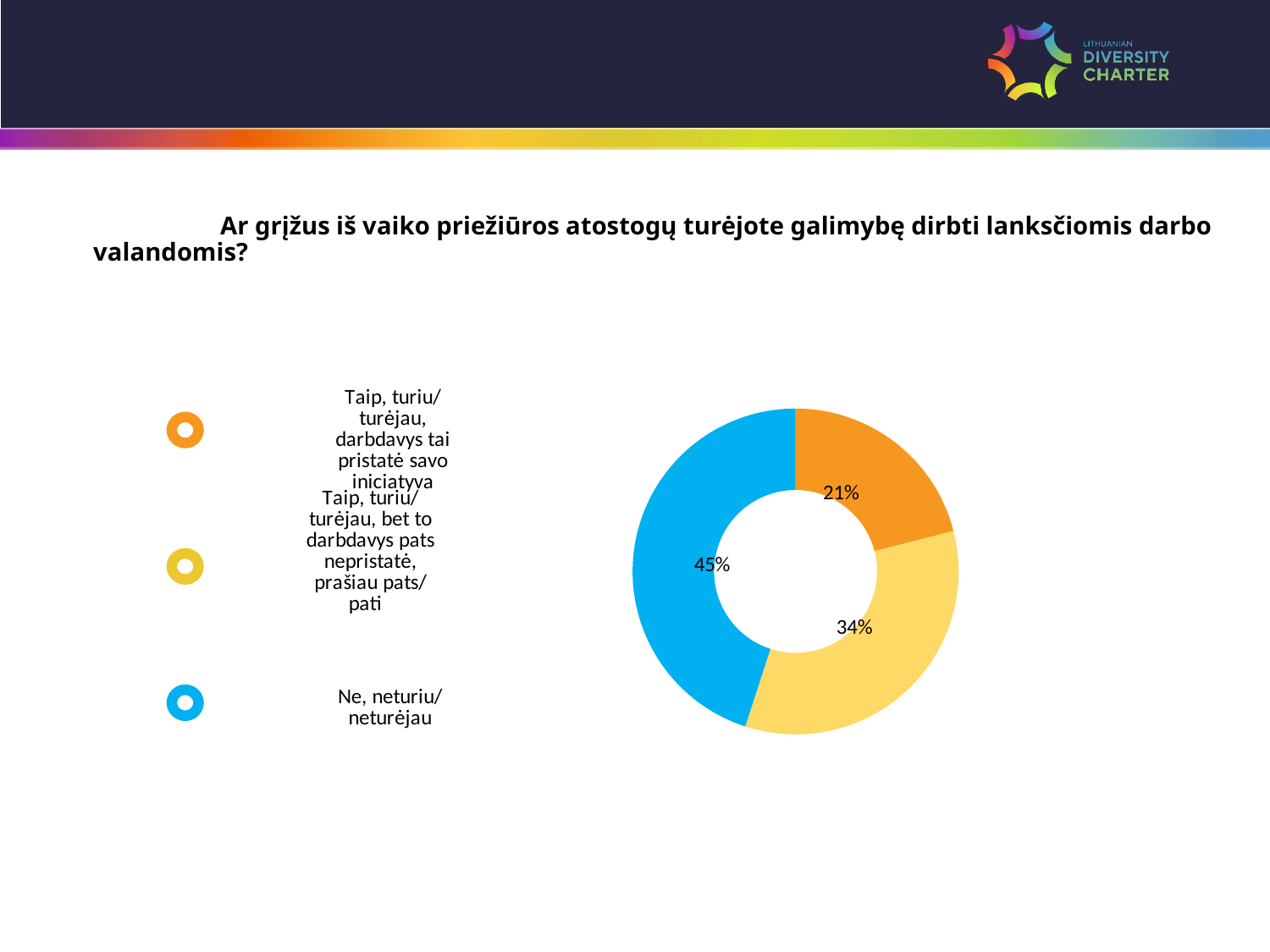
What is the difference in percentage points between the 34% slice and the 21% slice? 13 What percentage is shown for "Ne, neturiu/ neturėjau"? 45% What colour is the slice for "Ne, neturiu/ neturėjau"? Blue What percentage is shown for "Taip, turiu/ turėjau, darbdavys tai pristatė savo iniciatyva"? 21% What kind of chart is shown on the slide? Doughnut chart Which is larger: the share for "Ne, neturiu/ neturėjau" or the share for "Taip, turiu/ turėjau, bet to darbdavys pats nepristatė, prašiau pats/ pati"? Ne, neturiu/ neturėjau What colour is the slice labelled 21%? Orange How many categories does the chart show? 3 What is the difference in percentage points between "Ne, neturiu/ neturėjau" and "Taip, turiu/ turėjau, darbdavys tai pristatė savo iniciatyva"? 24 Which category has the largest share of the chart? Ne, neturiu/ neturėjau Which category has the smallest share of the chart? Taip, turiu/ turėjau, darbdavys tai pristatė savo iniciatyva What percentage is shown for "Taip, turiu/ turėjau, bet to darbdavys pats nepristatė, prašiau pats/ pati"? 34%